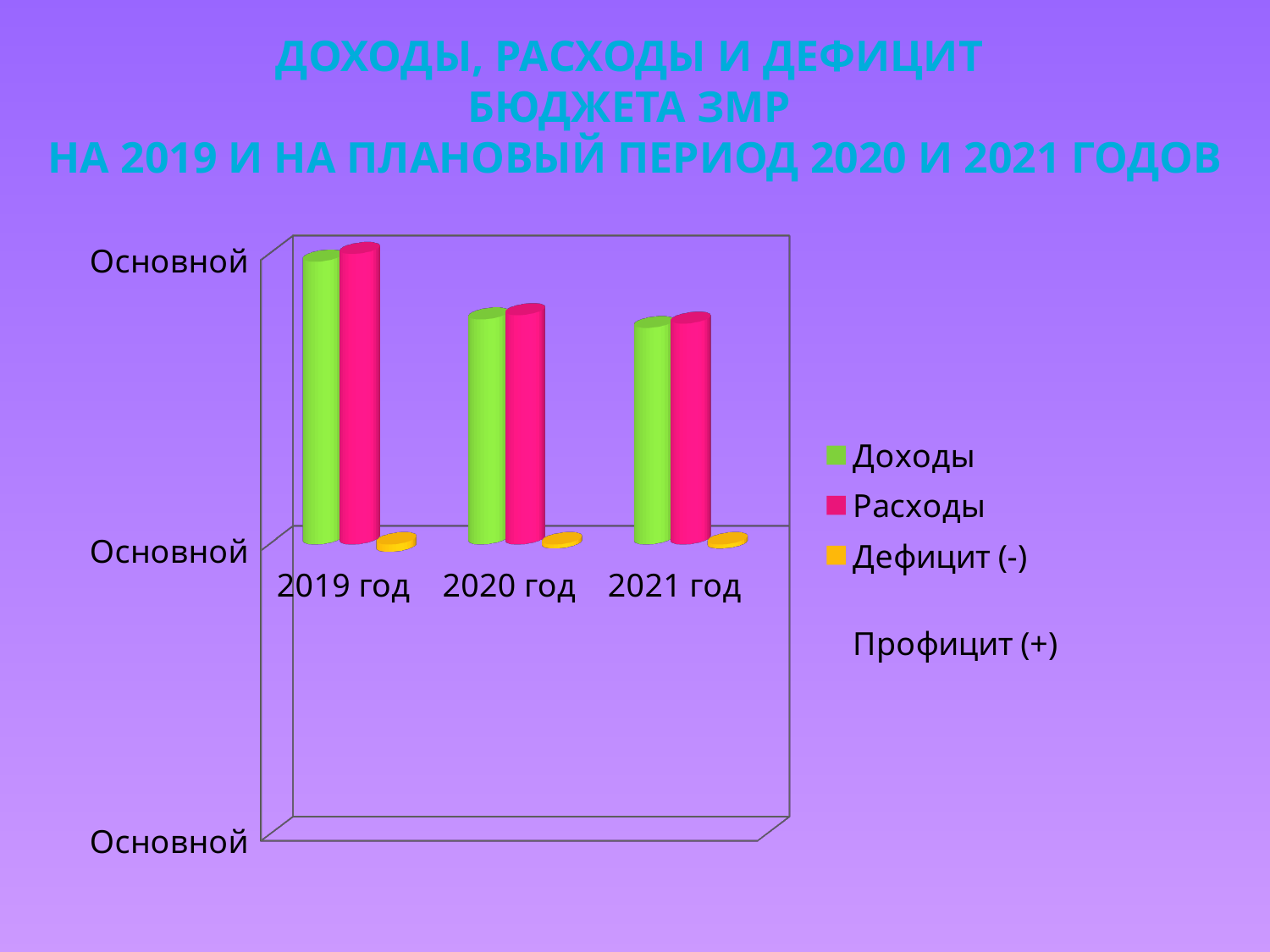
Do the Расходы values rise or fall from 2019 год to 2021 год? fall What kind of chart is shown on the slide? bar chart How many series does the legend list? 3 How many year categories are shown on the x axis? 3 Which series is shown in yellow in the legend? Дефицит (-) Профицит (+) Which year has the highest value for Доходы? 2019 год Which year has the highest value for Расходы? 2019 год Which is larger: Доходы in 2019 год or Доходы in 2021 год? Доходы in 2019 год Which is larger: Расходы in 2019 год or Расходы in 2020 год? Расходы in 2019 год Do the Доходы values rise or fall from 2019 год to 2021 год? fall Which year has the lowest value for Доходы? 2021 год Which colour represents the Доходы series in the legend? green